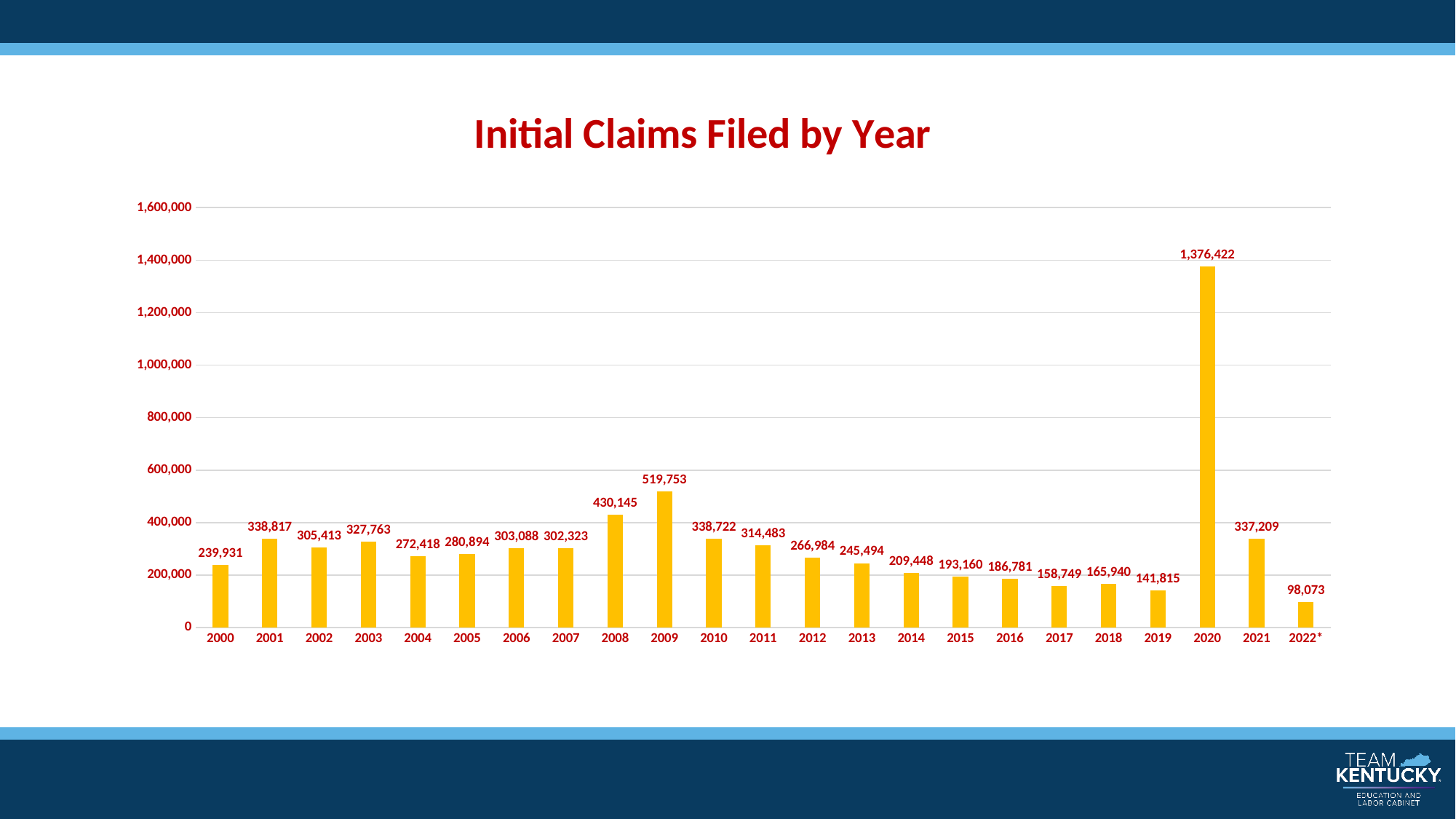
Which year has the highest number of initial claims filed? 2020 What kind of chart is this? Bar chart Which year has the lowest number of initial claims filed? 2022* Which is larger, the value for 2008 or the value for 2010? 2008 Is the value for 2009 greater or less than 400,000? greater Do the values rise or fall from 2010 to 2017? Fall What is the value for 2022*? 98,073 What is the value for 2009? 519,753 What is the difference between the values for 2020 and 2019? 1,234,607 What is the value for 2020? 1,376,422 How many years are shown on the x axis? 23 What is the difference between the values for 2009 and 2008? 89,608